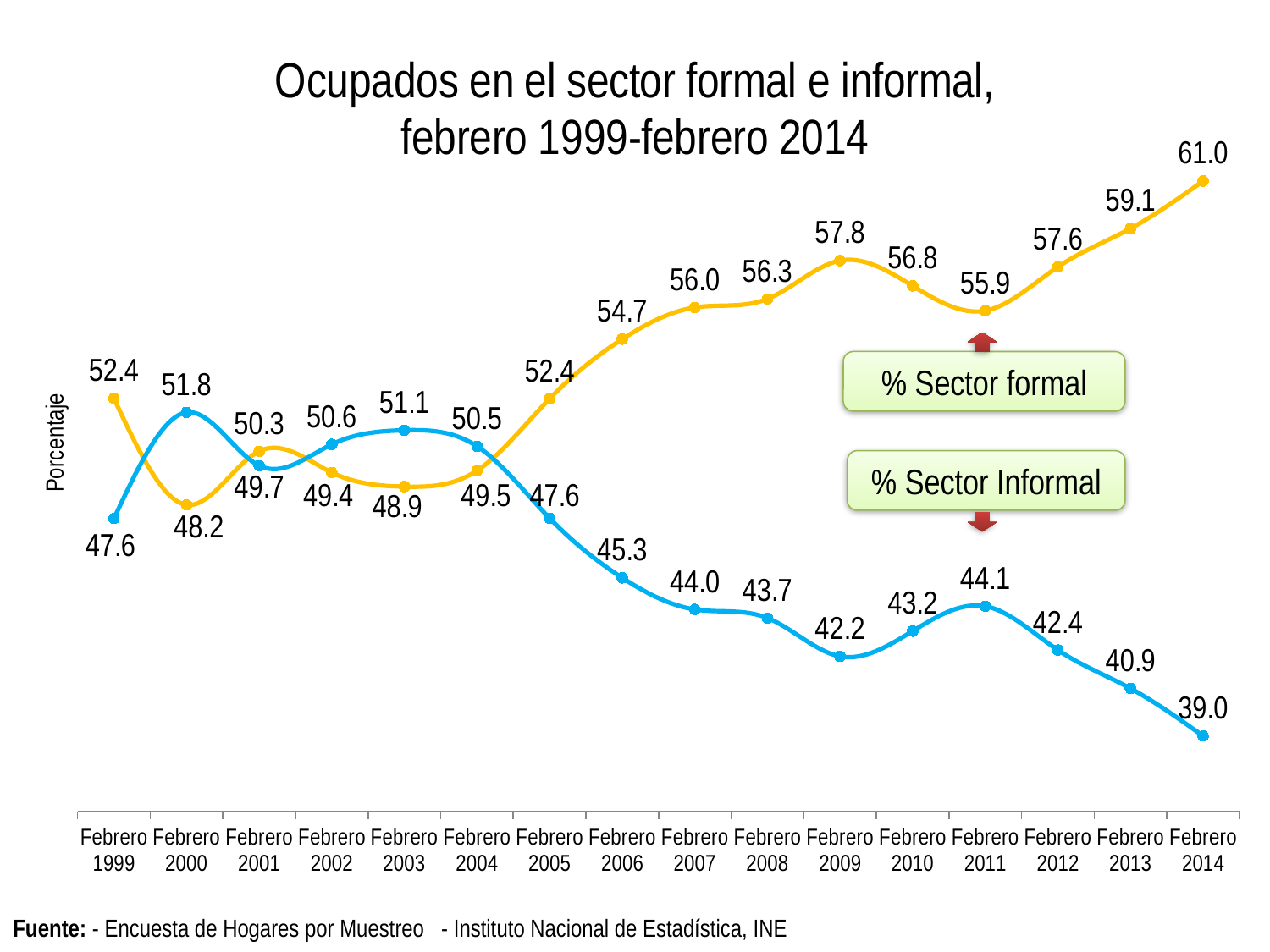
What is the difference between % Sector formal and % Sector Informal in Febrero 2014? 22.0 In which year does % Sector formal reach its highest value? Febrero 2014 What is the label of the y axis? Porcentaje In which year does % Sector Informal reach its lowest value? Febrero 2014 How many series does the chart show? 2 What is the value of % Sector formal in Febrero 2000? 48.2 Which is larger in Febrero 2003, % Sector formal or % Sector Informal? % Sector Informal What type of chart is shown on the slide? Line chart How many years (data points) are plotted along the x axis? 16 What is the value of % Sector Informal in Febrero 2009? 42.2 From Febrero 2005 to Febrero 2014, does % Sector Informal generally rise or fall? Fall What is the value of % Sector formal in Febrero 2014? 61.0